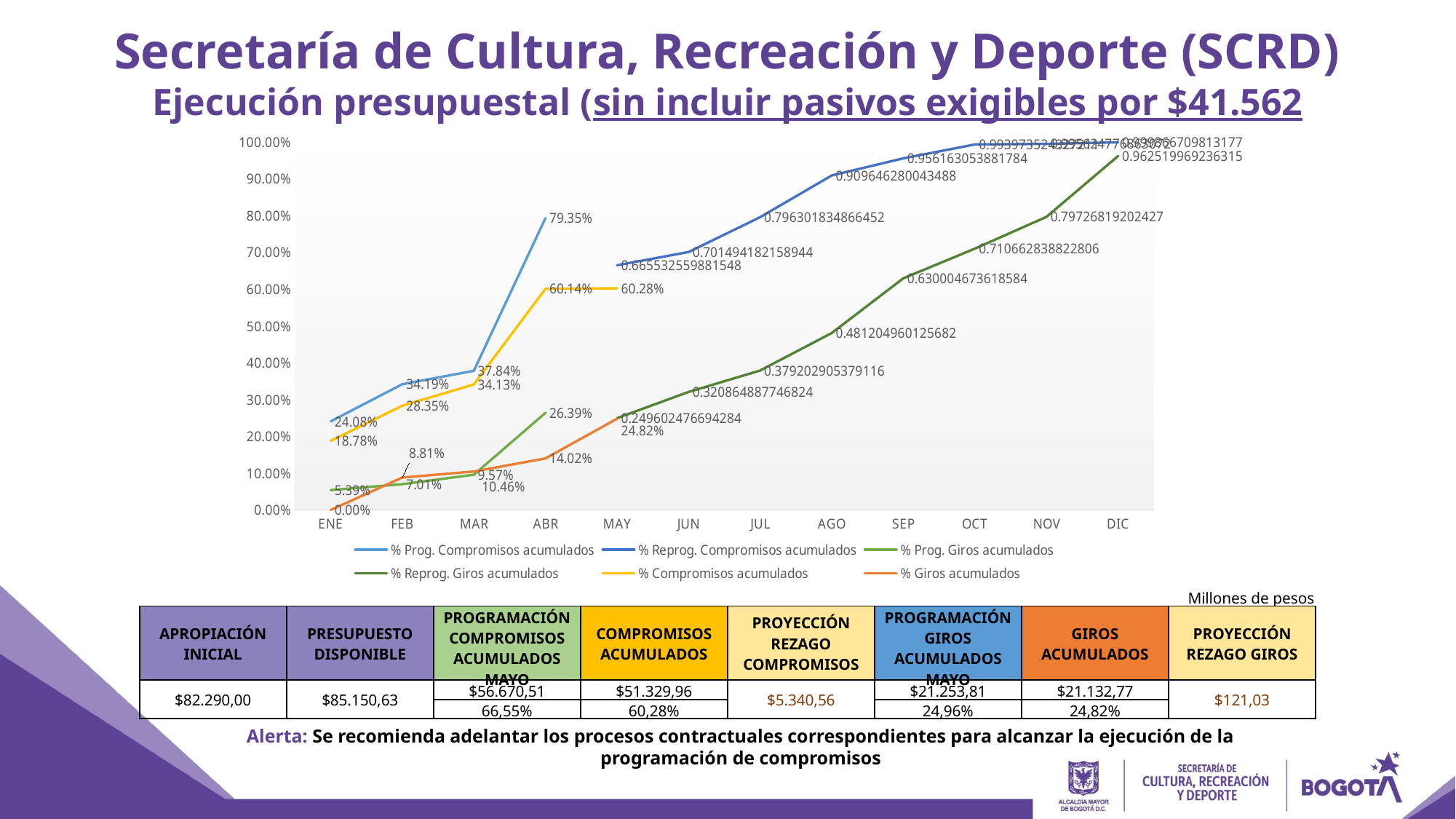
What is the value of % Reprog. Compromisos acumulados in JUN? 0.701494182158944 How many series does the chart legend list? 6 How many months are shown on the x axis of the chart? 12 In ABR, which is larger: % Prog. Giros acumulados or % Giros acumulados? % Prog. Giros acumulados What kind of chart is shown on the slide? line chart What is the value of % Compromisos acumulados in MAY? 60.28% Is the value of % Reprog. Giros acumulados in AGO greater or less than 50%? less What is the value of % Giros acumulados in MAY? 24.82% What is the value of % Prog. Compromisos acumulados in ABR? 79.35% Does % Reprog. Giros acumulados rise or fall from MAY to DIC? rise What is the value of % Reprog. Giros acumulados in DIC? 0.962519969236315 What is the difference between % Prog. Compromisos acumulados and % Compromisos acumulados in ABR? 19.21 percentage points